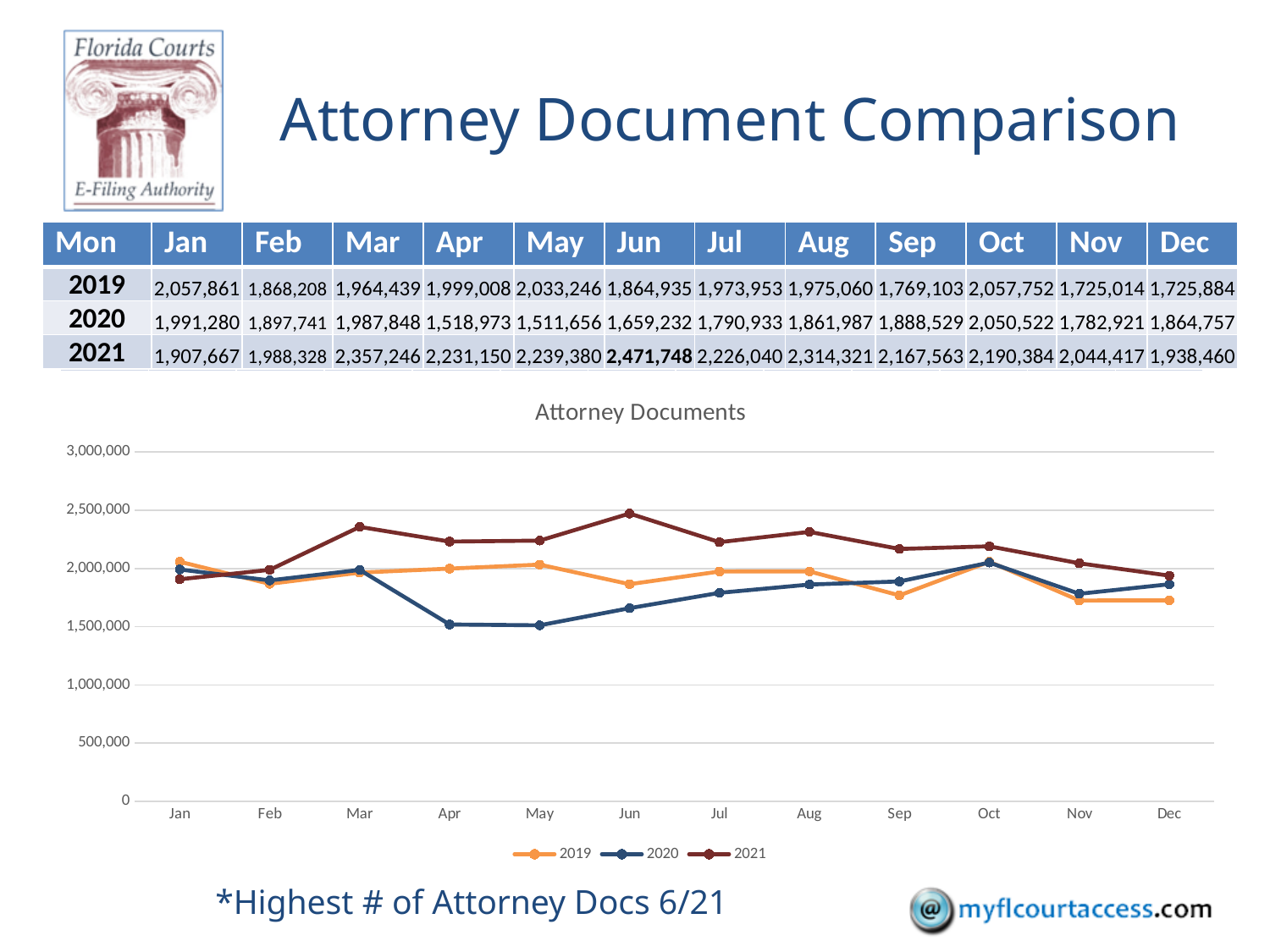
Does the 2020 series rise or fall from May to October? rise What is the value for 2019 in October? 2,057,752 How many series does the chart legend list? 3 In which month does the 2021 series reach its highest value? Jun How many months are plotted along the x axis of the chart? 12 Is the value for 2020 in May greater or less than 2,000,000? less In which month does the 2020 series reach its lowest value? May Which is larger in March, the 2021 value or the 2019 value? 2021 What is the value for 2021 in June? 2,471,748 What is the value for 2020 in April? 1,518,973 What is the difference between the 2021 and 2020 values in June? 812,516 What type of chart is shown on the slide? line chart